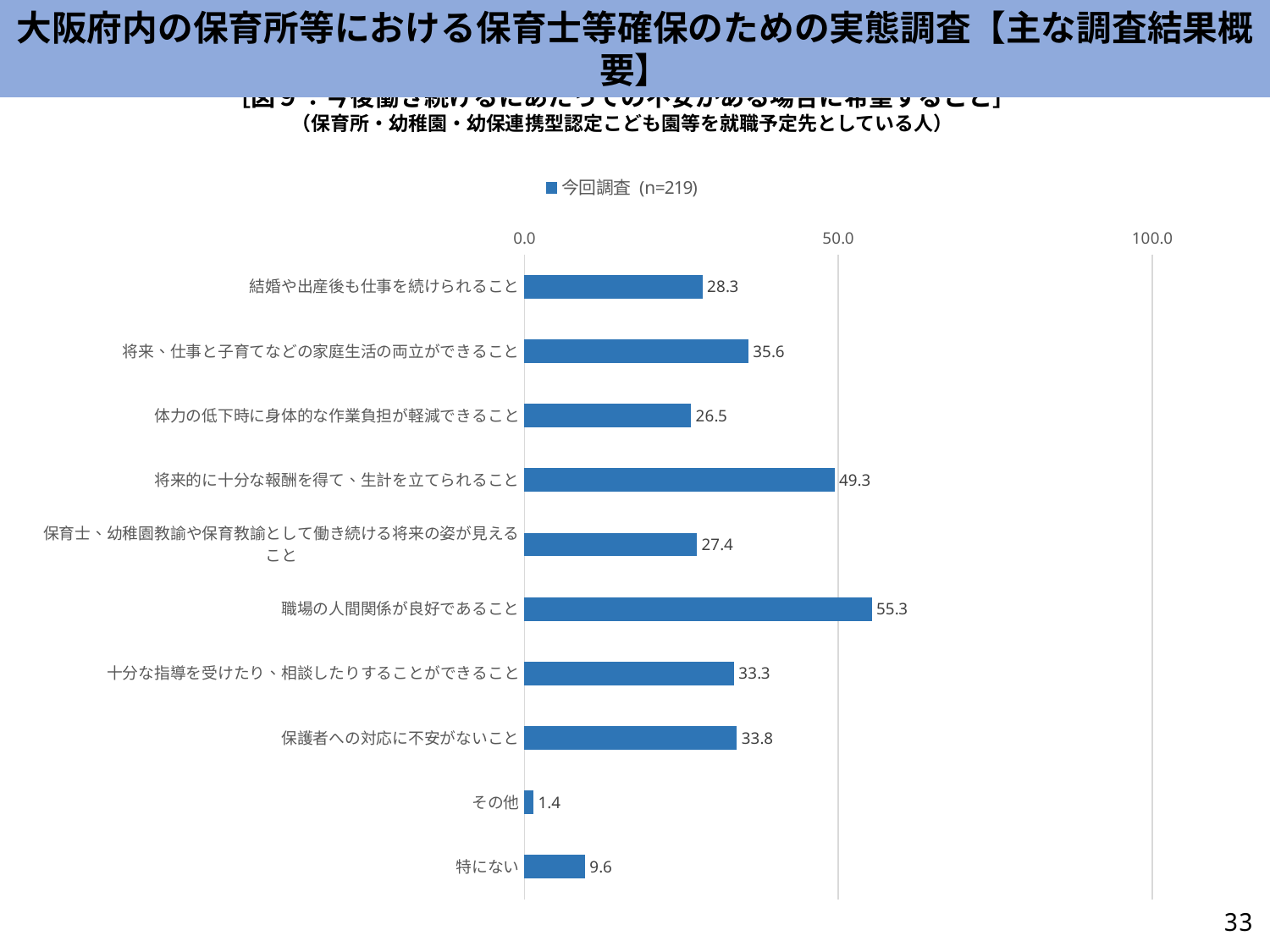
What is the value for 職場の人間関係が良好であること? 55.3 What is the difference between the values for 職場の人間関係が良好であること and 将来的に十分な報酬を得て、生計を立てられること? 6.0 Which category has the lowest value? その他 What is the value for 将来的に十分な報酬を得て、生計を立てられること? 49.3 What kind of chart is shown on the slide? bar chart What is the sample size (n) shown in the legend? n=219 What is the value for 特にない? 9.6 How many series does the legend list? 1 Is the value for 体力の低下時に身体的な作業負担が軽減できること greater or less than 50.0? less How many categories are shown in the chart? 10 Which category has the highest value? 職場の人間関係が良好であること Which is larger, the value for 結婚や出産後も仕事を続けられること or the value for 将来、仕事と子育てなどの家庭生活の両立ができること? 将来、仕事と子育てなどの家庭生活の両立ができること